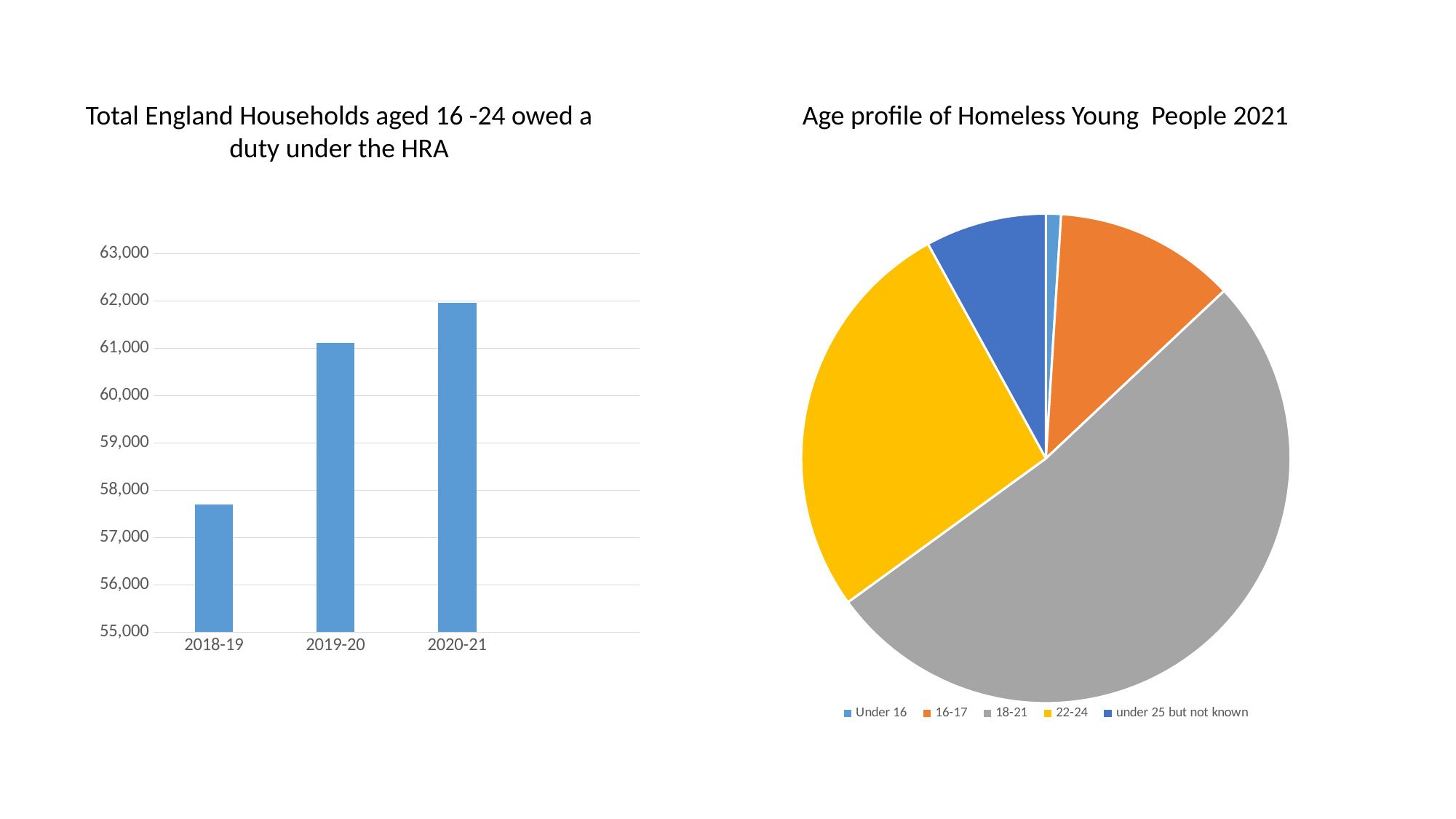
On the right chart, 'Age profile of Homeless Young People 2021', which age group has the largest slice? 18-21 On the right chart, 'Age profile of Homeless Young People 2021', what kind of chart is shown? pie chart On the left chart, 'Total England Households aged 16 -24 owed a duty under the HRA', is the value for 2018-19 greater or less than 58,000? less On the left chart, 'Total England Households aged 16 -24 owed a duty under the HRA', what kind of chart is shown? bar chart On the left chart, 'Total England Households aged 16 -24 owed a duty under the HRA', which year has the highest value? 2020-21 On the left chart, 'Total England Households aged 16 -24 owed a duty under the HRA', which is larger, the value for 2019-20 or 2018-19? 2019-20 On the right chart, 'Age profile of Homeless Young People 2021', how many age categories does the legend list? 5 On the right chart, 'Age profile of Homeless Young People 2021', which age group has the smallest slice? Under 16 On the left chart, 'Total England Households aged 16 -24 owed a duty under the HRA', how many years are plotted? 3 On the left chart, 'Total England Households aged 16 -24 owed a duty under the HRA', do the values rise or fall from 2018-19 to 2020-21? rise On the left chart, 'Total England Households aged 16 -24 owed a duty under the HRA', is the value for 2019-20 greater or less than 60,000? greater On the left chart, 'Total England Households aged 16 -24 owed a duty under the HRA', which year has the lowest value? 2018-19